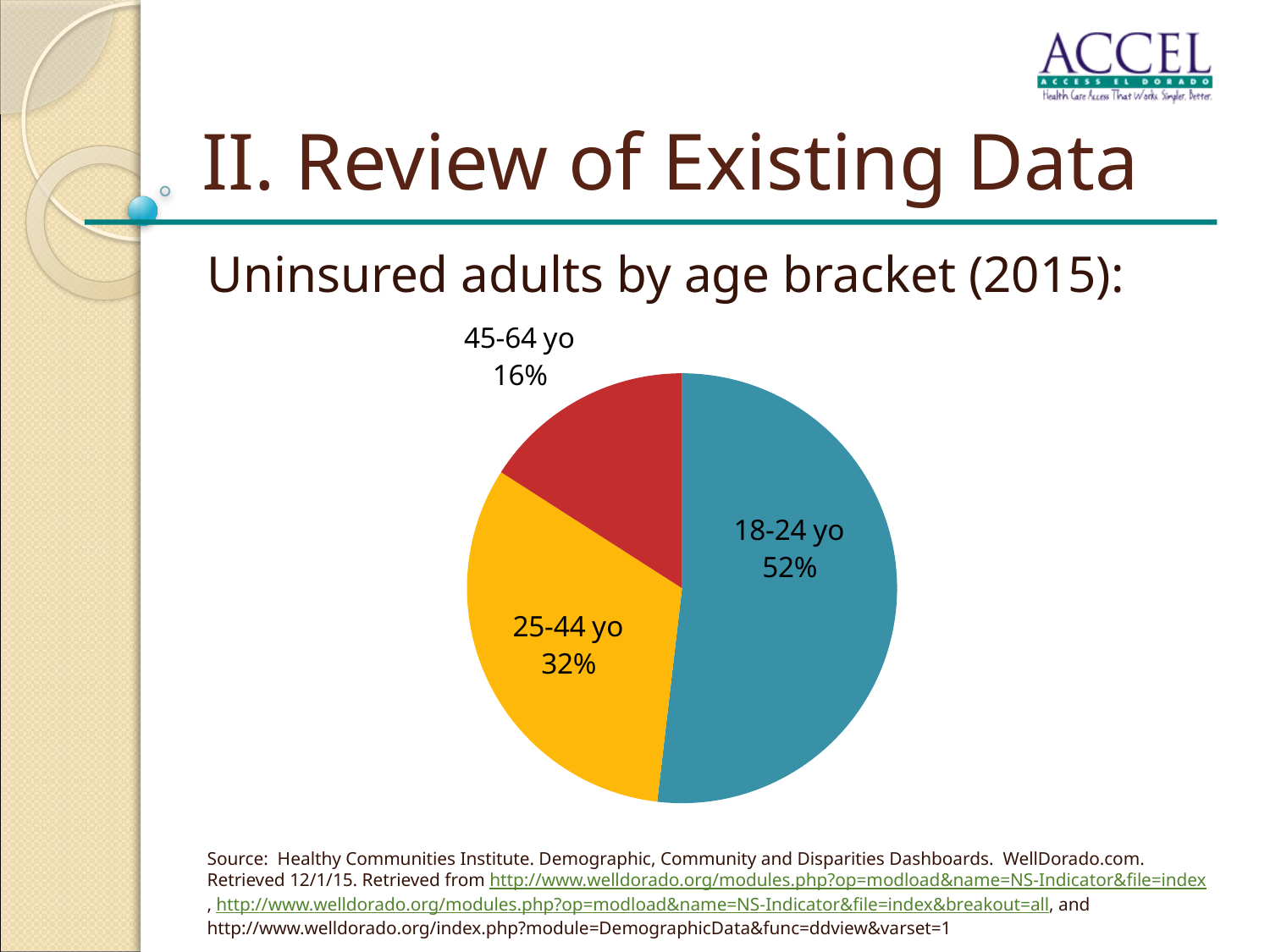
What kind of chart is shown on the slide? pie chart What is the title of the pie chart? Uninsured adults by age bracket (2015): What share of uninsured adults is in the 25-44 yo age bracket? 32% What colour is the 18-24 yo slice? blue How many age brackets are shown in the pie chart? 3 Which is larger, the share for 25-44 yo or the share for 45-64 yo? 25-44 yo Which age bracket has the smallest share of uninsured adults? 45-64 yo Which age bracket has the largest share of uninsured adults? 18-24 yo What share of uninsured adults is in the 18-24 yo age bracket? 52% What is the difference in percentage points between the 25-44 yo and 45-64 yo slices? 16 What share of uninsured adults is in the 45-64 yo age bracket? 16% What is the difference in percentage points between the 18-24 yo and 25-44 yo slices? 20